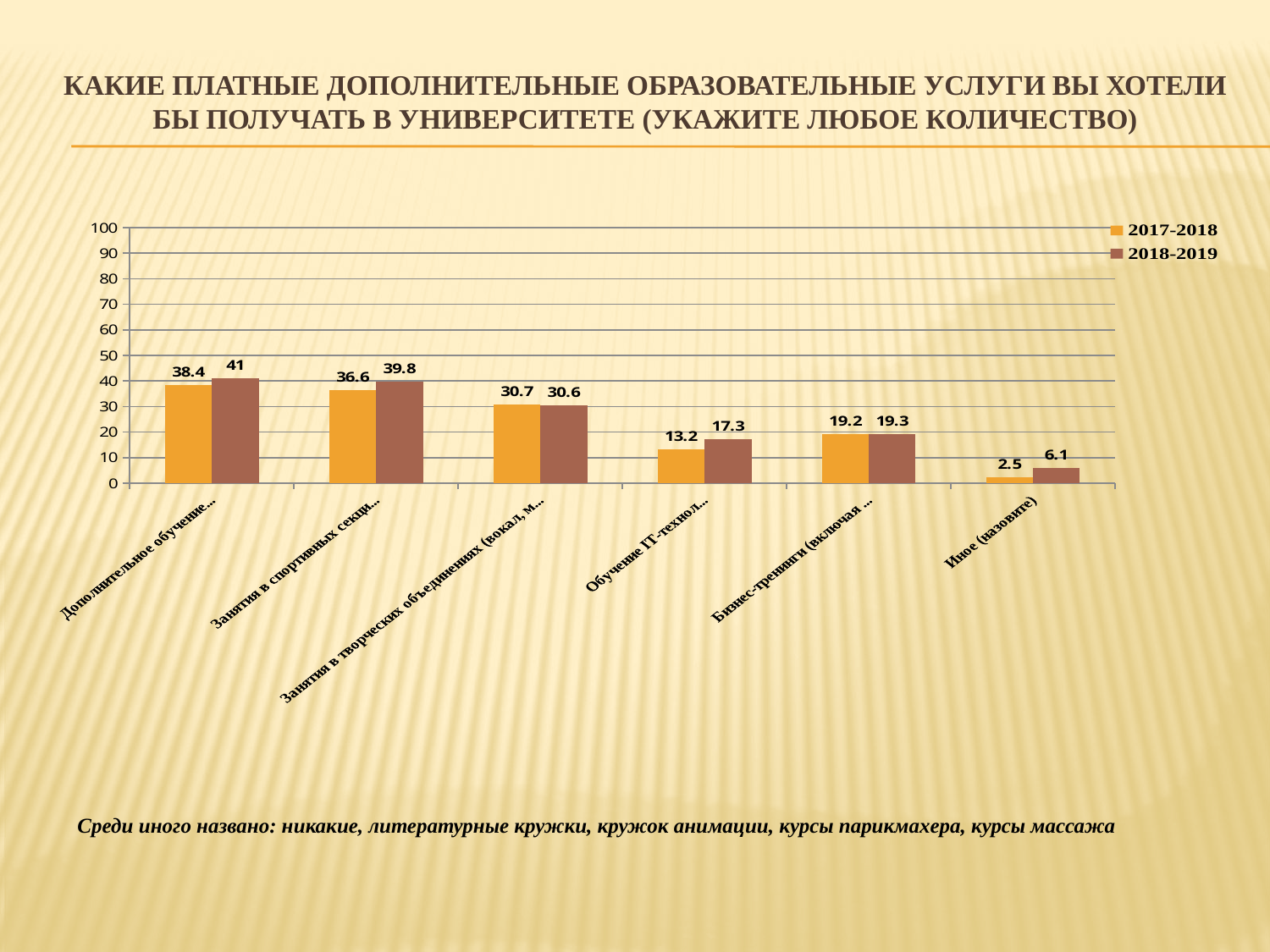
What type of chart is shown on the slide? bar chart What is the difference between the 2018-2019 and 2017-2018 values for the category beginning "Обучение IT-технол"? 4.1 Which category has the lowest 2017-2018 value? Иное (назовите) What is the 2017-2018 value for the category "Иное (назовите)"? 2.5 What is the 2018-2019 value for the category beginning "Дополнительное обучение"? 41 How many categories are shown on the x axis? 6 How many series does the legend list? 2 Which category has the highest 2018-2019 value? Дополнительное обучение... What is the 2017-2018 value for the category beginning "Обучение IT-технол"? 13.2 For the category beginning "Занятия в спортивных секци", which series has the larger value, 2017-2018 or 2018-2019? 2018-2019 What are the two entries in the chart legend? 2017-2018 and 2018-2019 What is the 2018-2019 value for the category "Иное (назовите)"? 6.1